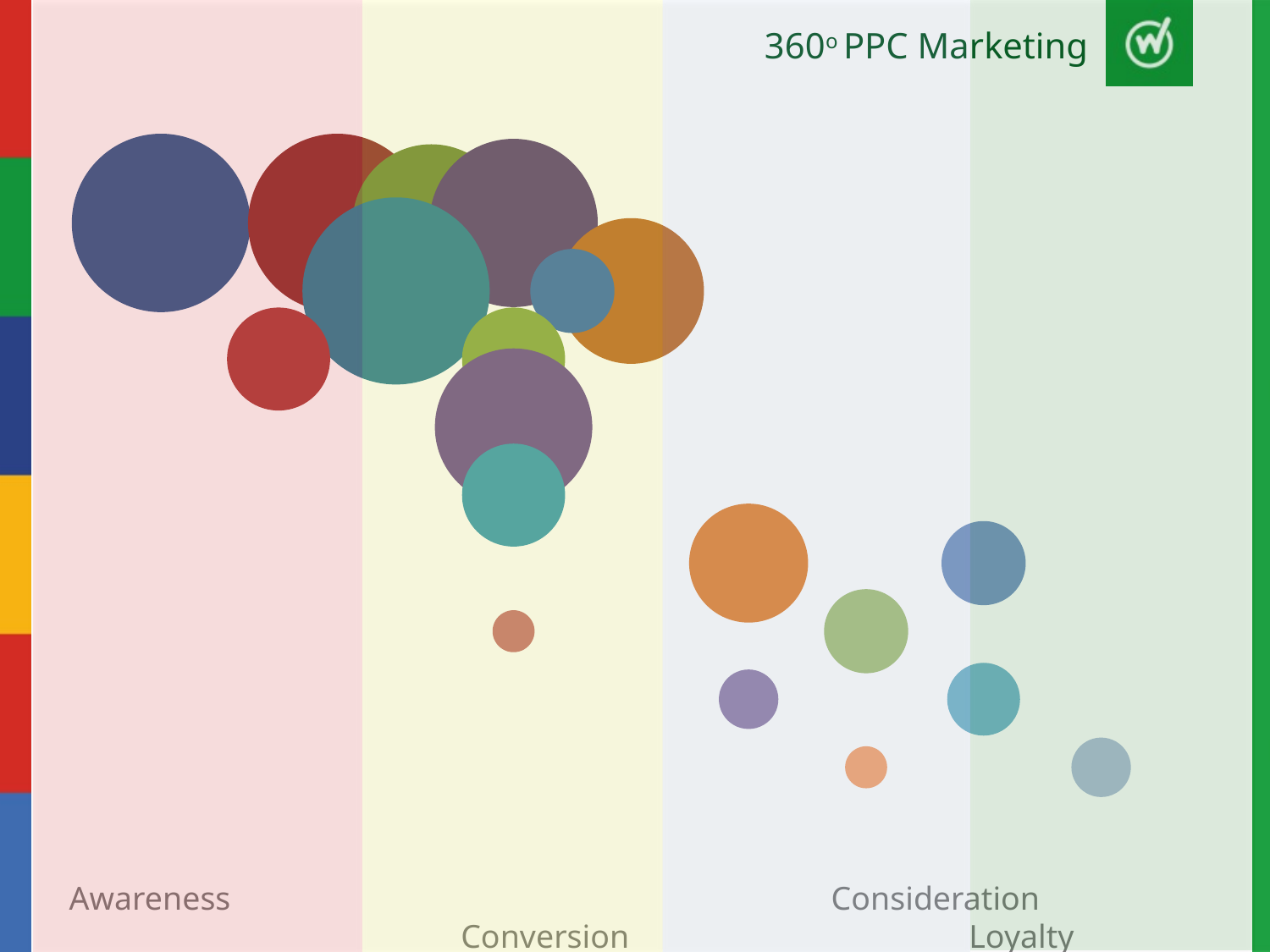
What kind of chart is shown on the slide? bubble chart What is the title of the chart? 360º PPC Marketing How many funnel stages are labelled along the bottom of the chart? 4 Does the size of the bubbles generally increase or decrease moving from the Awareness stage to the Loyalty stage? decrease Are the bubbles in the Loyalty region larger or smaller than the bubbles in the Awareness region? smaller How many bubbles are in the Loyalty region of the chart? 3 Which stage label appears at the far left of the chart? Awareness How many bubbles are in the Consideration region of the chart? 4